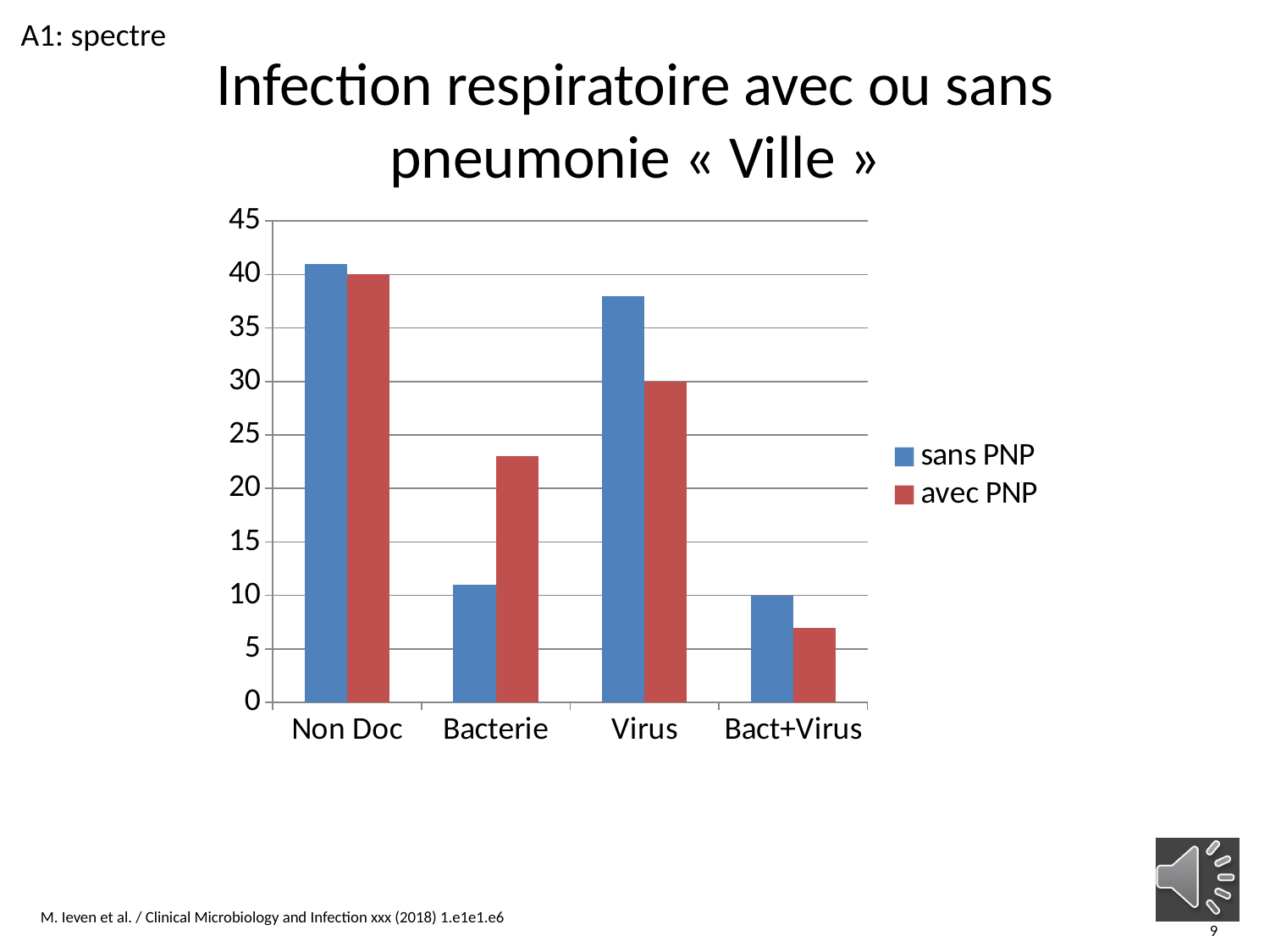
How many series does the legend list? 2 What is the title of the chart? Infection respiratoire avec ou sans pneumonie « Ville » Is the avec PNP value for Bacterie greater or less than 20? greater Which category has the lowest value for the avec PNP series? Bact+Virus How many categories are shown on the x axis? 4 For the Bacterie category, which series has the larger value, sans PNP or avec PNP? avec PNP Is the sans PNP value for Virus greater or less than 35? greater Which category has the highest value for the sans PNP series? Non Doc Is the sans PNP value for Bacterie greater or less than 15? less Which category has the lowest value for the sans PNP series? Bact+Virus What kind of chart is shown on the slide? bar chart For the Virus category, which series has the larger value, sans PNP or avec PNP? sans PNP